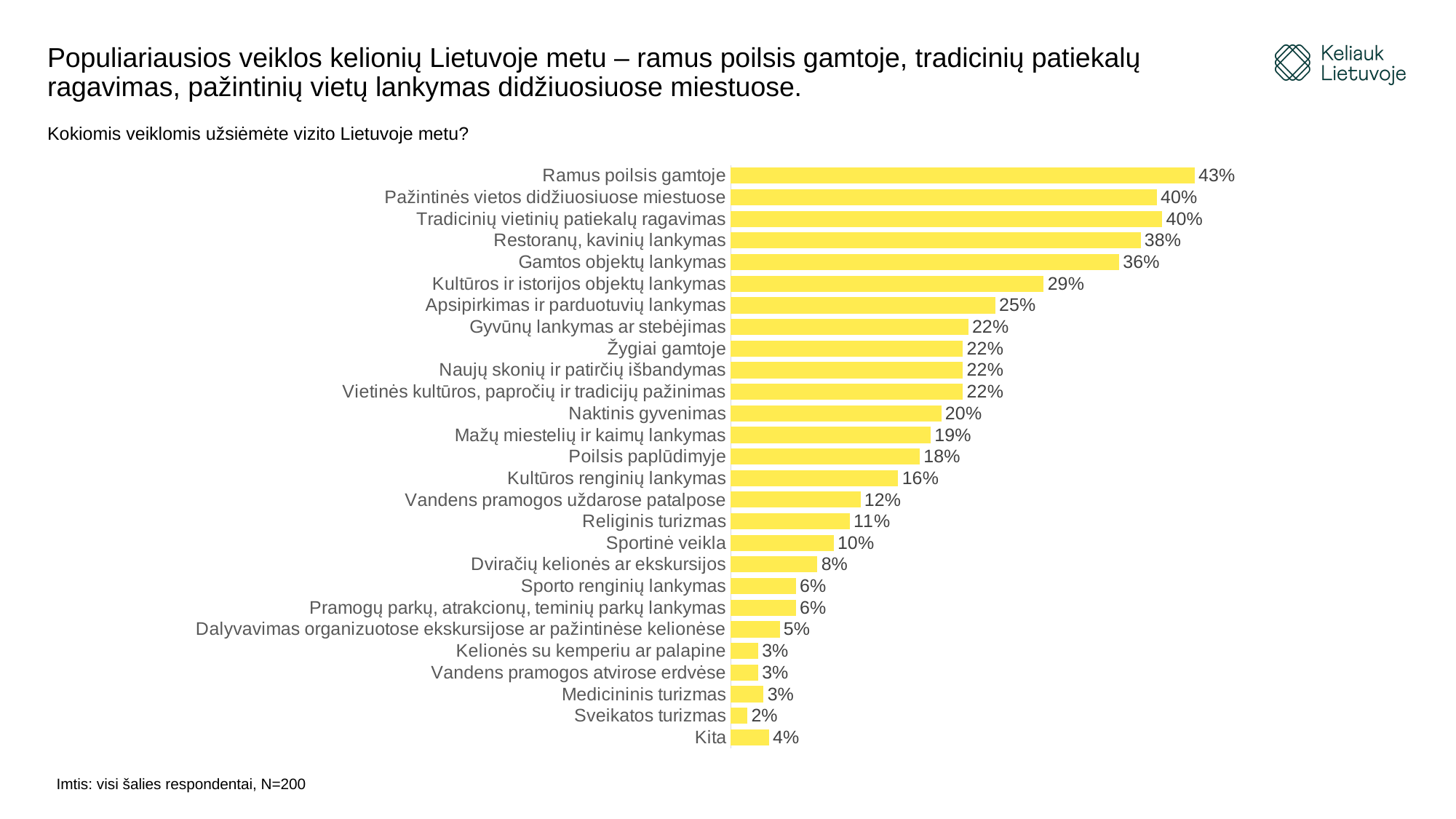
Which activity has the lowest percentage? Sveikatos turizmas What is the value shown for "Naktinis gyvenimas"? 20% Which activity has the highest percentage? Ramus poilsis gamtoje Which has a higher value: "Restoranų, kavinių lankymas" or "Kultūros ir istorijos objektų lankymas"? Restoranų, kavinių lankymas What percentage of respondents chose "Ramus poilsis gamtoje"? 43% What is the value shown for "Religinis turizmas"? 11% What is the value shown for "Kita"? 4% How many activity categories are shown in the chart? 27 What is the difference in percentage points between "Ramus poilsis gamtoje" and "Gamtos objektų lankymas"? 7 What type of chart is shown on the slide? Bar chart What is the difference in percentage points between "Kultūros renginių lankymas" and "Sportinė veikla"? 6 What colour are the bars in the chart? Yellow